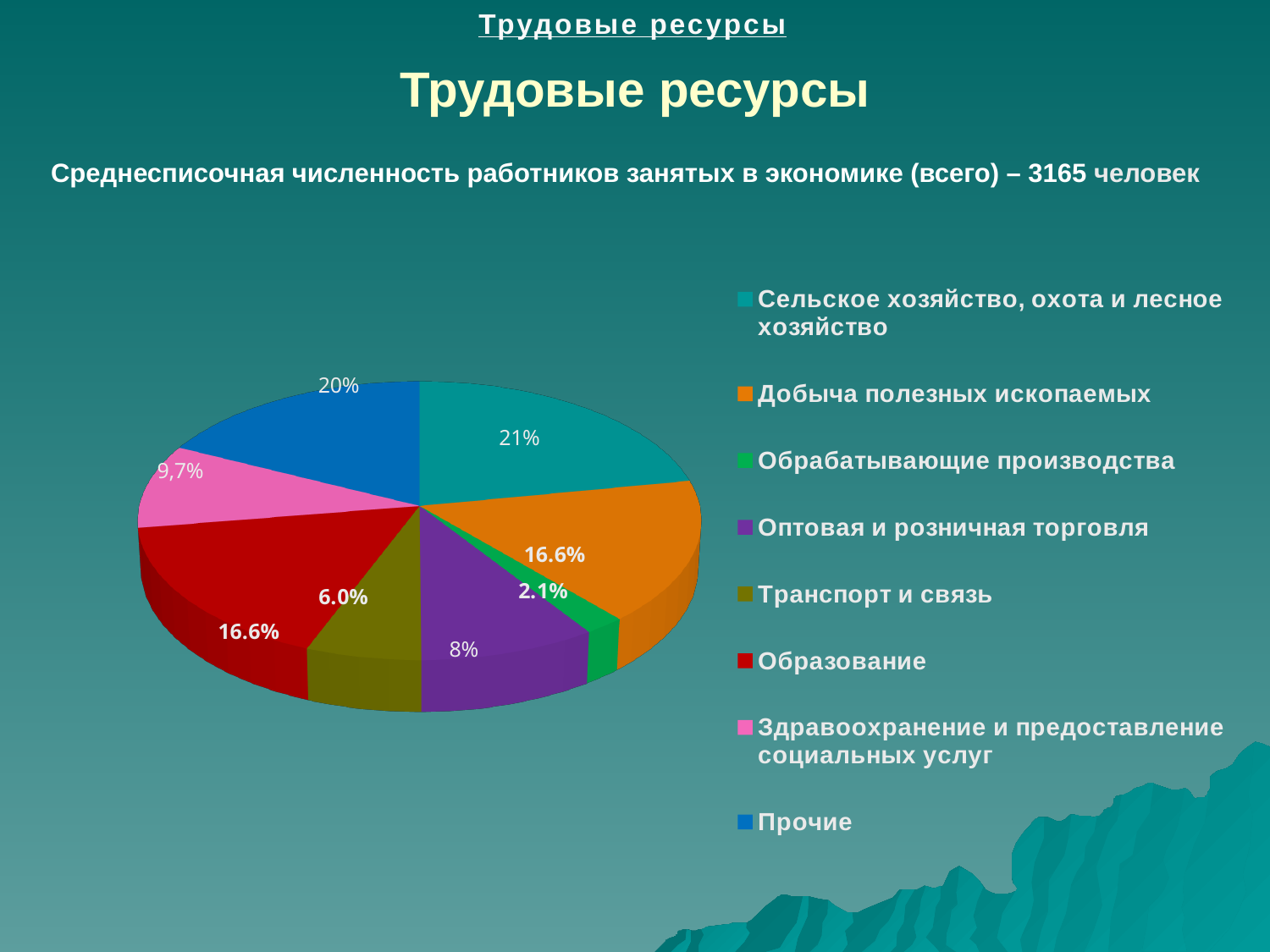
What kind of chart is shown on the slide? pie chart Which category has the largest slice of the pie? Сельское хозяйство, охота и лесное хозяйство Which is larger: the slice for Образование or the slice for Оптовая и розничная торговля? Образование What share of the pie is labelled for Сельское хозяйство, охота и лесное хозяйство? 21% What share of the pie is labelled for Транспорт и связь? 6.0% What share of the pie is labelled for Обрабатывающие производства? 2.1% What share of the pie is labelled for Оптовая и розничная торговля? 8% What share of the pie is labelled for Добыча полезных ископаемых? 16.6% What share of the pie is labelled for Прочие? 20% What share of the pie is labelled for Здравоохранение и предоставление социальных услуг? 9,7% Which category has the smallest slice of the pie? Обрабатывающие производства How many categories does the legend of the pie chart list? 8